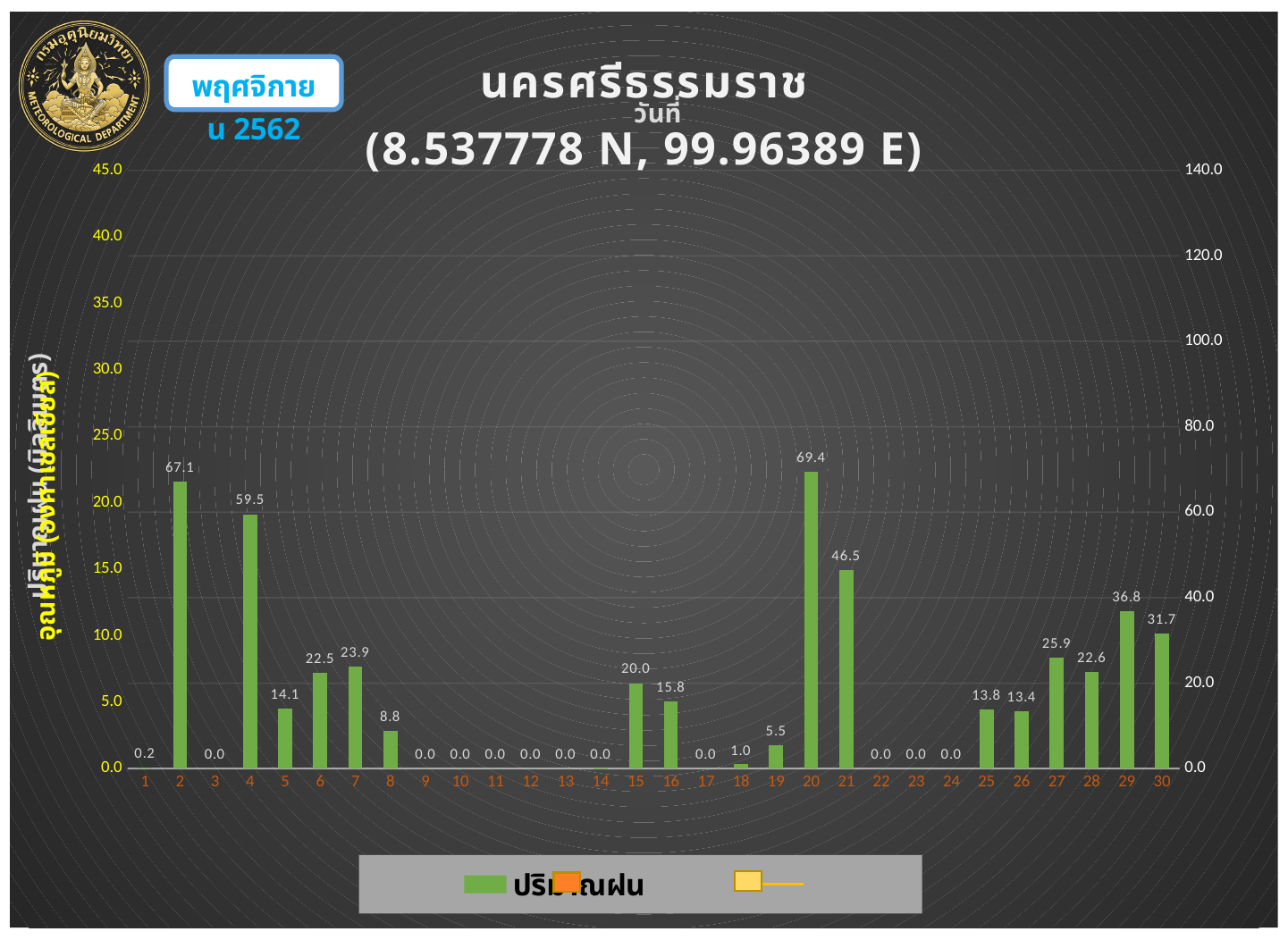
What is the difference between the values for day 29 and day 30? 5.1 What is the value for day 15? 20.0 What is the legend label for the green bars? ปริมาณฝน Which day has the highest value? 20 What is the difference between the values for day 20 and day 2? 2.3 Which is larger, the value for day 4 or the value for day 21? day 4 What is the value for day 29? 36.8 What is the value for day 2? 67.1 What is the value for day 20? 69.4 What is the value for day 18? 1.0 What kind of chart is this? bar chart How many days are shown on the x axis? 30